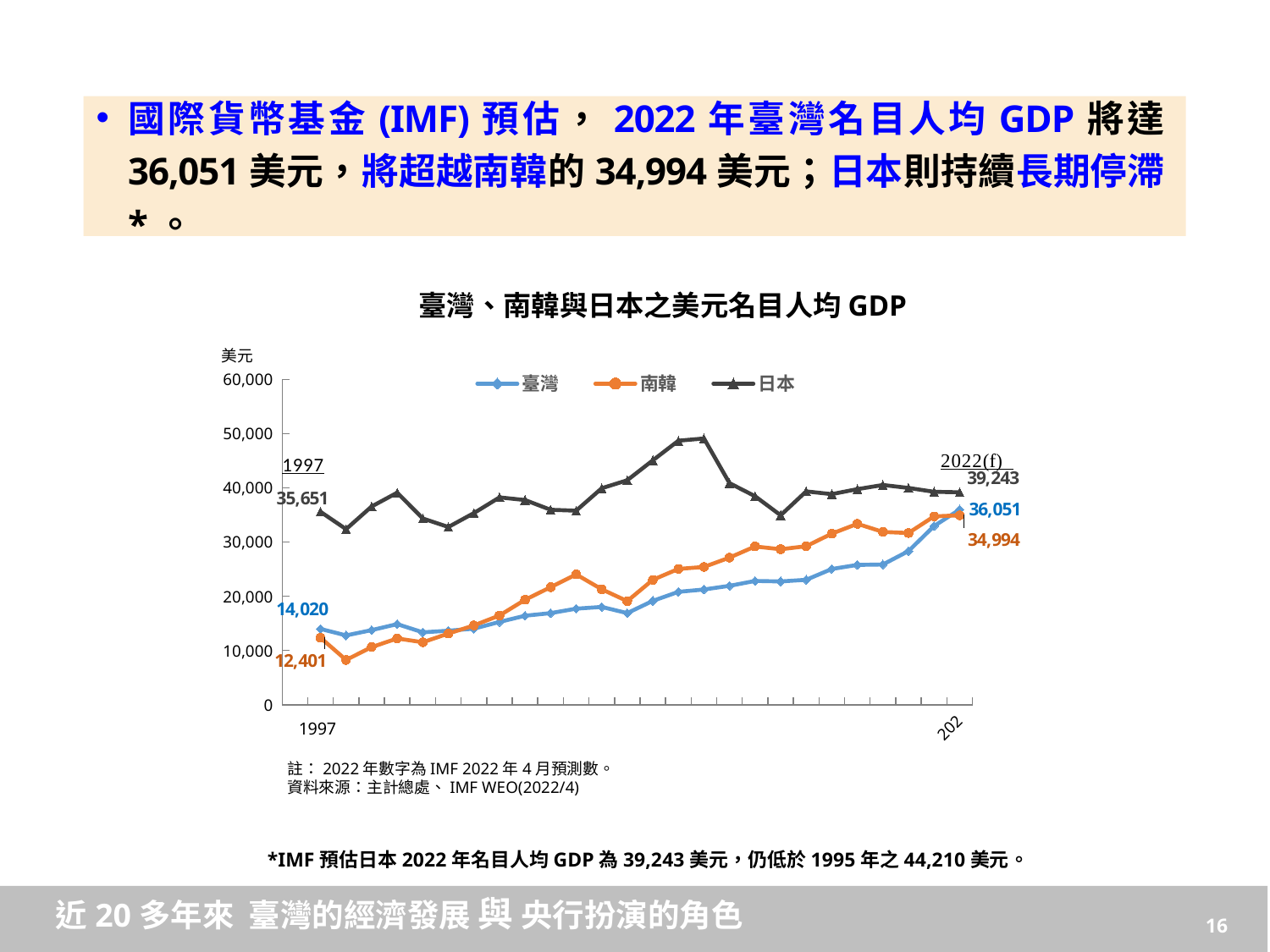
What is the value for 南韓 in 1997? 12,401 What is the difference between the 2022(f) values for 臺灣 and 南韓? 1,057 What is the value for 日本 in 2022(f)? 39,243 Does the value for 臺灣 rise or fall from 1997 to 2022(f)? rise What type of chart is shown on the slide? line chart What is the value for 南韓 in 2022(f)? 34,994 How many series does the legend list? 3 What is the value for 臺灣 in 2022(f)? 36,051 What is the value for 臺灣 in 1997? 14,020 Which series has the highest value in 2022(f)? 日本 Which series has the lowest value in 1997? 南韓 What is the value for 日本 in 1997? 35,651